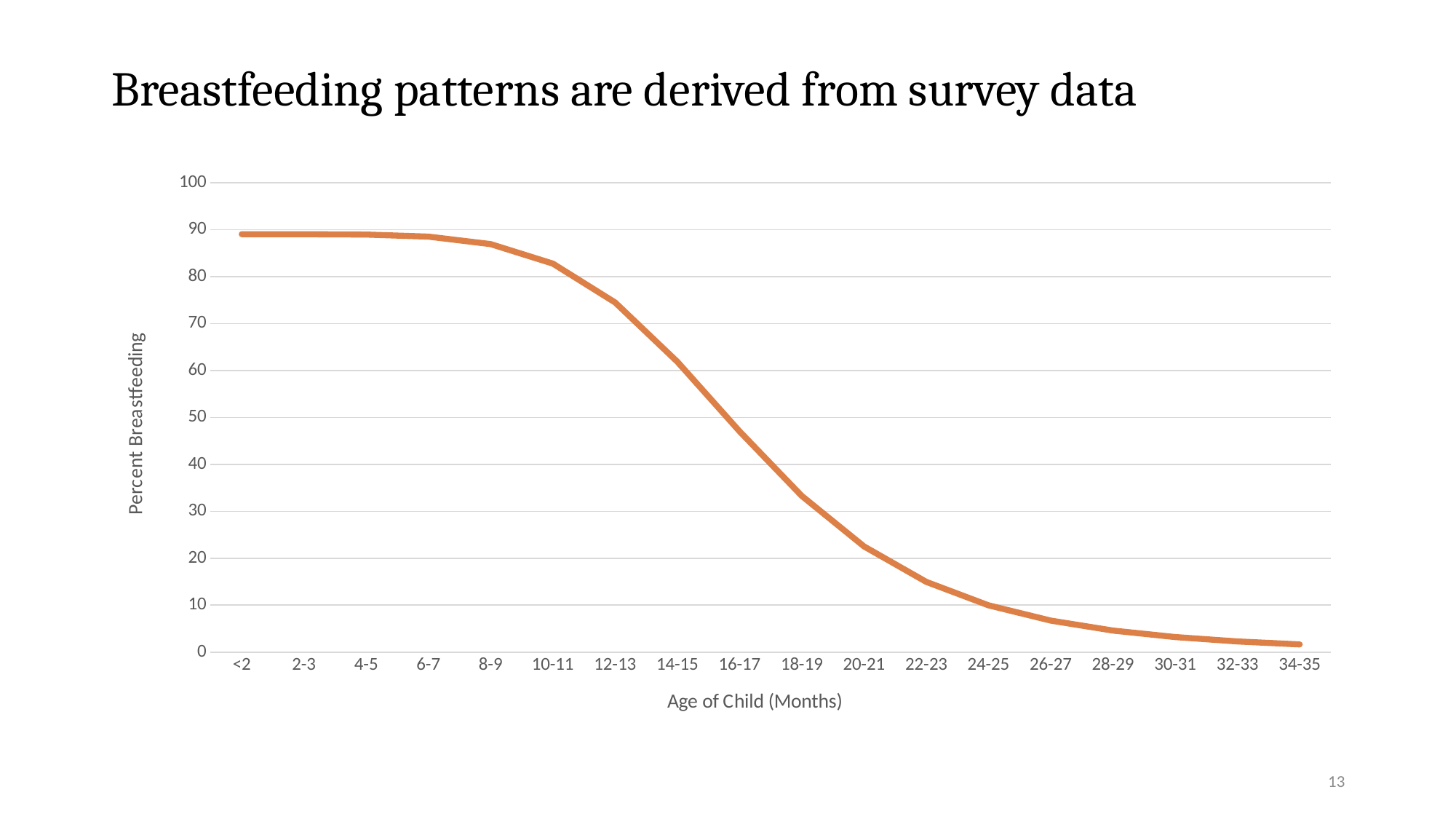
Is the value for 14-15 greater or less than 50? greater Is the value for 34-35 greater or less than 10? less What is the label of the y axis? Percent Breastfeeding Is the value for <2 greater or less than 80? greater Which age category has the lowest percent breastfeeding? 34-35 How many age categories are shown on the x axis? 18 What kind of chart is shown on the slide? line chart Which has a higher percent breastfeeding, 8-9 or 20-21? 8-9 Do the values rise or fall as the age of the child increases along the x axis? fall